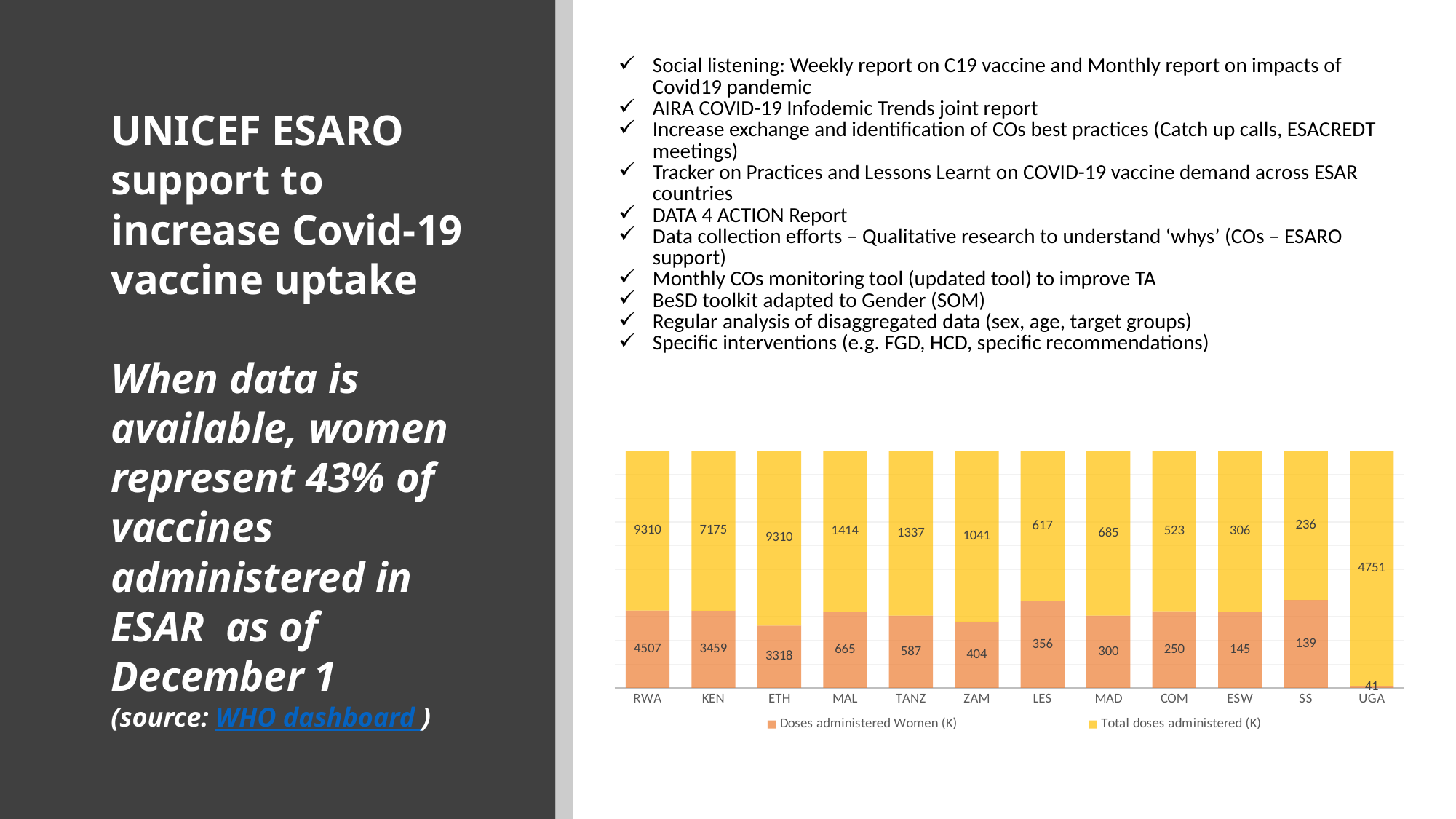
Which country has the highest value for Doses administered Women (K)? RWA What is the value of Total doses administered (K) for UGA? 4751 How many series does the chart legend list? 2 What type of chart is shown on the slide? bar chart Which series in the legend is shown in yellow? Total doses administered (K) What is the difference between Total doses administered (K) and Doses administered Women (K) for MAL? 749 What is the value of Doses administered Women (K) for UGA? 41 How many countries are shown on the x axis of the chart? 12 Which is larger, Total doses administered (K) for LES or for MAD? MAD What is the value of Doses administered Women (K) for RWA? 4507 Which country has the lowest value for Total doses administered (K)? SS What is the value of Total doses administered (K) for KEN? 7175